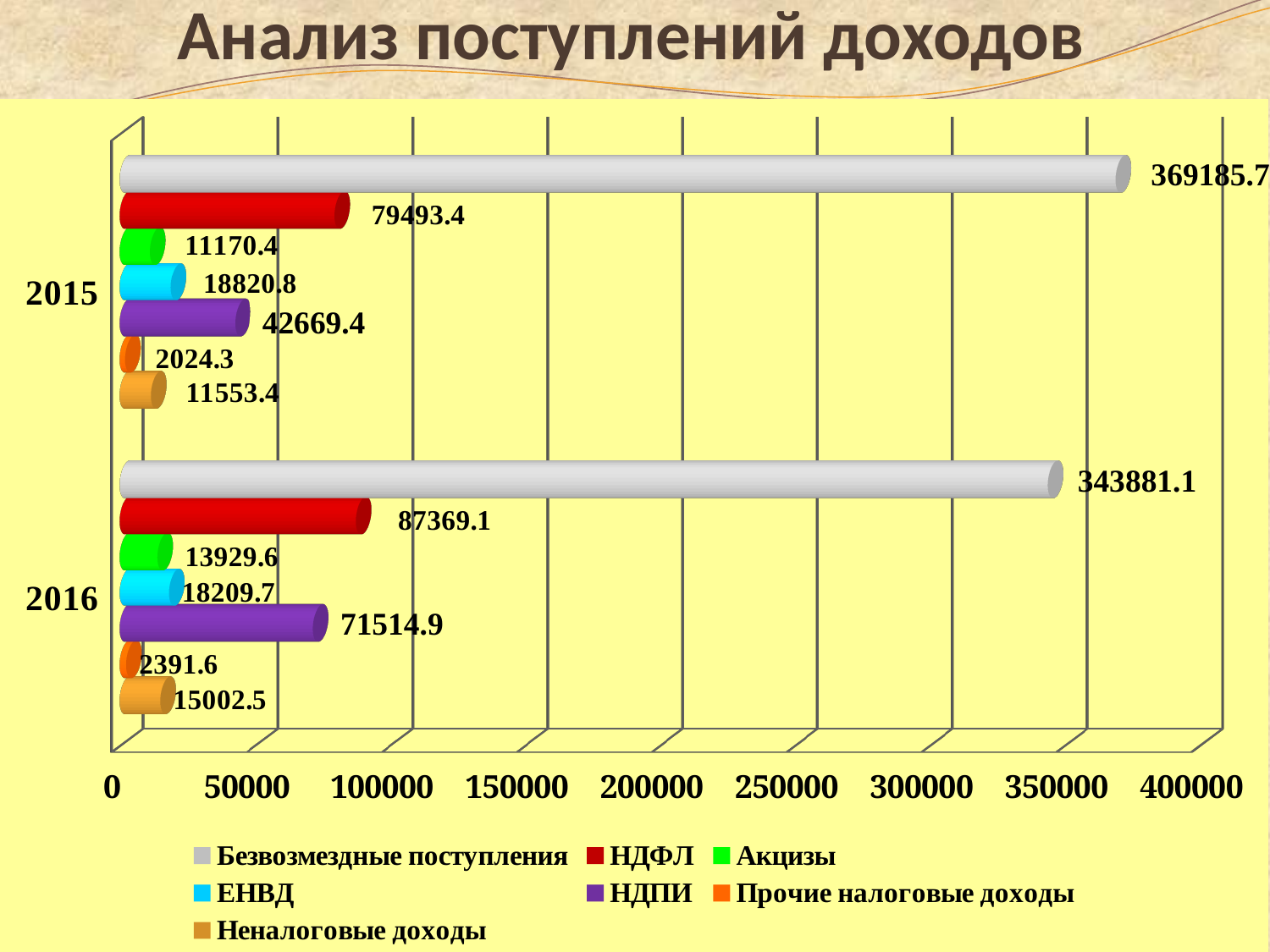
What type of chart is shown on the slide? bar chart Which series has the lowest value for 2015? Прочие налоговые доходы Is the value of Безвозмездные поступления for 2016 greater or less than 300000? greater What is the title of the slide? Анализ поступлений доходов What is the value of Прочие налоговые доходы for 2015? 2024.3 What is the value of Неналоговые доходы for 2016? 15002.5 What is the value of НДПИ for 2016? 71514.9 How many series does the legend list? 7 What is the value of Безвозмездные поступления for 2015? 369185.7 What is the difference between the НДПИ values for 2016 and 2015? 28845.5 Which series has the highest value for 2016? Безвозмездные поступления Which is larger, the НДФЛ value for 2015 or for 2016? 2016